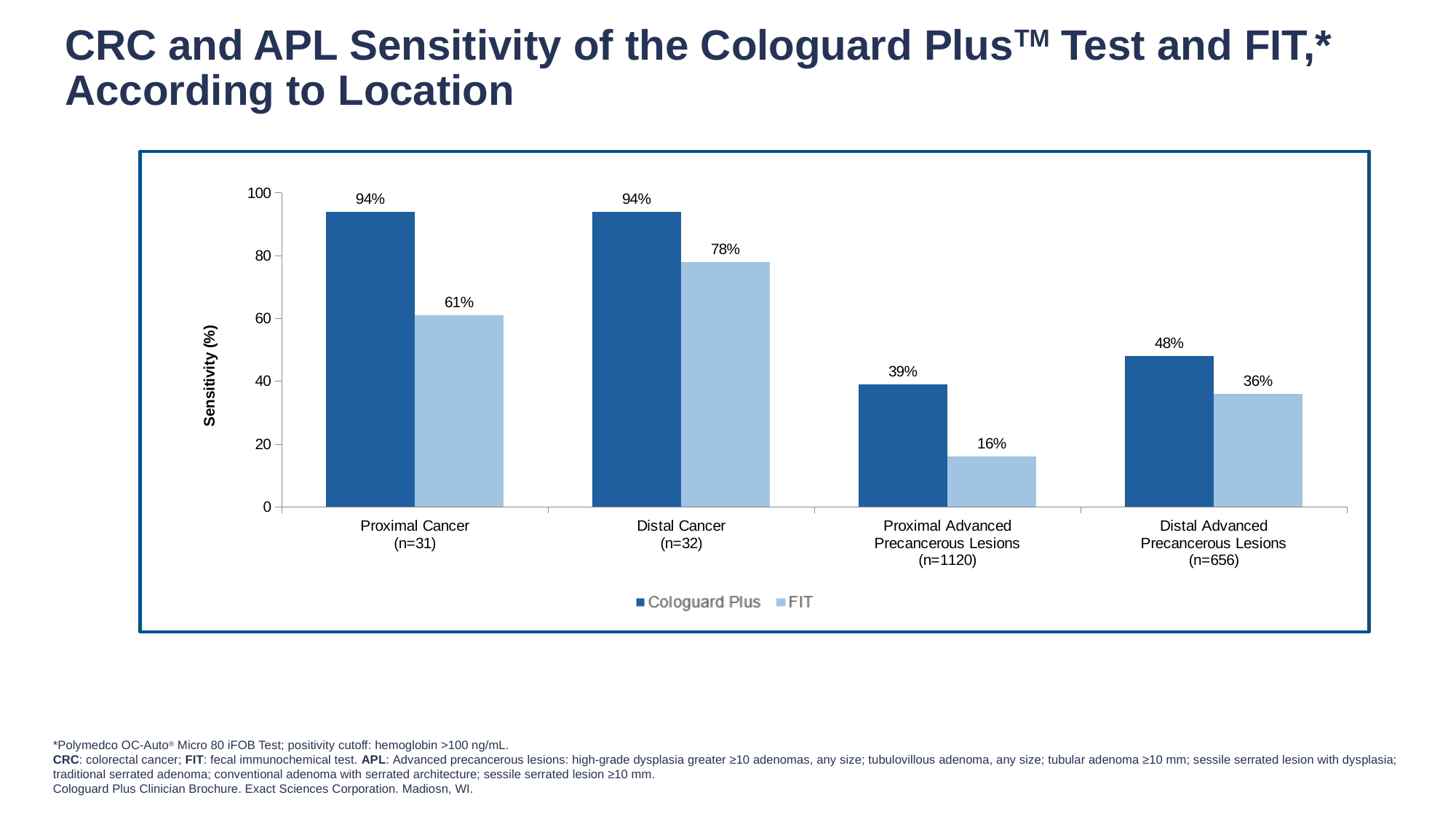
What is the Cologuard Plus sensitivity for Distal Advanced Precancerous Lesions (n=656)? 48% What is the difference between the Cologuard Plus and FIT sensitivity for Proximal Cancer (n=31)? 33% What is the Cologuard Plus sensitivity for Proximal Cancer (n=31)? 94% Which category has the lowest Cologuard Plus sensitivity? Proximal Advanced Precancerous Lesions (n=1120) What is the difference between the Cologuard Plus and FIT sensitivity for Proximal Advanced Precancerous Lesions (n=1120)? 23% For Distal Advanced Precancerous Lesions (n=656), which test has the higher sensitivity, Cologuard Plus or FIT? Cologuard Plus How many categories are shown on the x axis of the chart? 4 What is the FIT sensitivity for Distal Cancer (n=32)? 78% What type of chart is shown on the slide? Bar chart Which category has the lowest FIT sensitivity? Proximal Advanced Precancerous Lesions (n=1120) What is the FIT sensitivity for Proximal Advanced Precancerous Lesions (n=1120)? 16% How many series does the chart legend list? 2